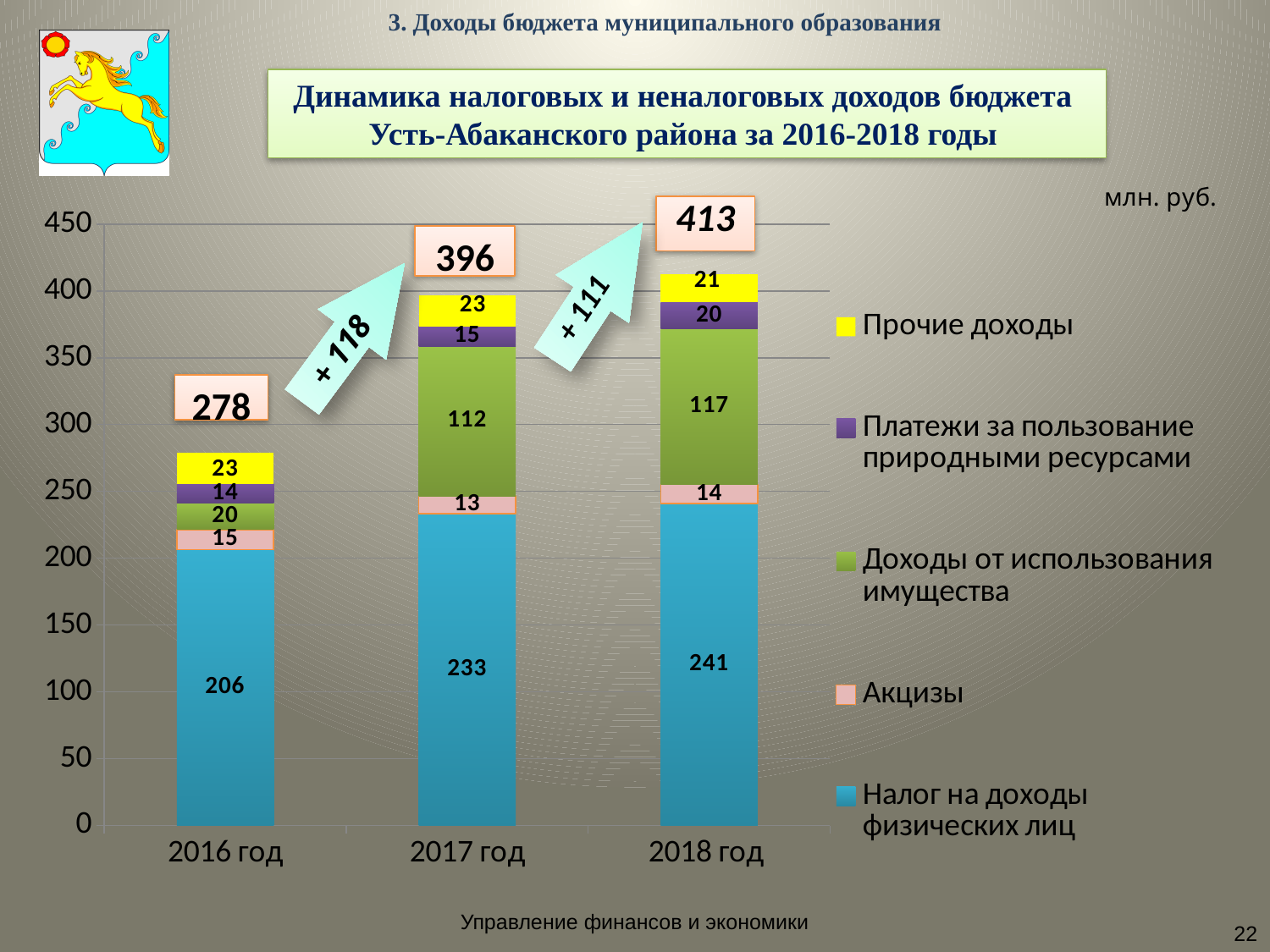
What is the total of the stacked bar for 2016 год? 278 Which is larger: Прочие доходы in 2017 год or Прочие доходы in 2018 год? 2017 год What is the total of the stacked bar for 2018 год? 413 How many series does the legend list? 5 What is the value for Акцизы in 2017 год? 13 What is the value for Доходы от использования имущества in 2017 год? 112 Which year has the highest total income? 2018 год Which year has the lowest value for Доходы от использования имущества? 2016 год What is the difference between the Налог на доходы физических лиц values for 2018 год and 2016 год? 35 What is the value for Платежи за пользование природными ресурсами in 2018 год? 20 What kind of chart is shown on the slide? stacked bar chart What is the value for Налог на доходы физических лиц in 2016 год? 206